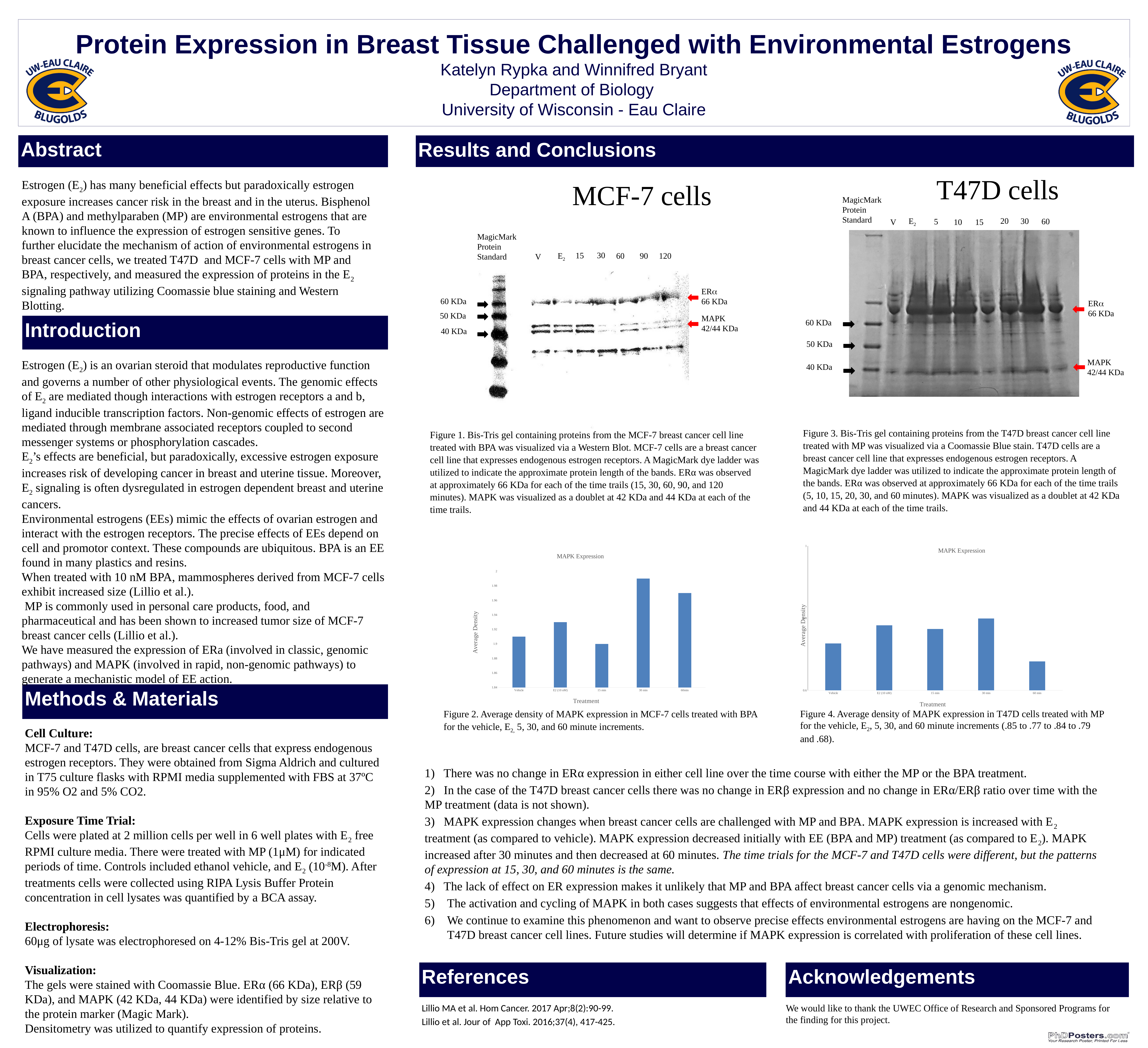
In the MAPK Expression chart for MCF-7 cells (Figure 2), which is larger, the value for 30 min or the value for 60 min? 30 min In the MAPK Expression chart for T47D cells (Figure 4), which treatment has the lowest average density? 60 min In the MAPK Expression chart for T47D cells (Figure 4), which is larger, the value for Vehicle or the value for E2 (10 nM)? E2 (10 nM) In the MAPK Expression chart for MCF-7 cells (Figure 2), is the value for E2 (10 nM) greater or less than 1.9? greater In the MAPK Expression chart for MCF-7 cells (Figure 2), is the value for 30 min greater or less than 1.96? greater What is the y-axis label of the MAPK Expression chart for T47D cells (Figure 4)? Average Density In the MAPK Expression chart for MCF-7 cells (Figure 2), is the value for 15 min greater or less than 1.92? less What kind of chart is the MAPK Expression chart under the MCF-7 cells gel (Figure 2)? bar chart How many treatment categories are plotted in the MAPK Expression chart for MCF-7 cells (Figure 2)? 5 In the MAPK Expression chart for T47D cells (Figure 4), which treatment has the highest average density? 30 min In the MAPK Expression chart for MCF-7 cells (Figure 2), which treatment has the highest average density? 30 min What is the x-axis label of the MAPK Expression chart for MCF-7 cells (Figure 2)? Treatment